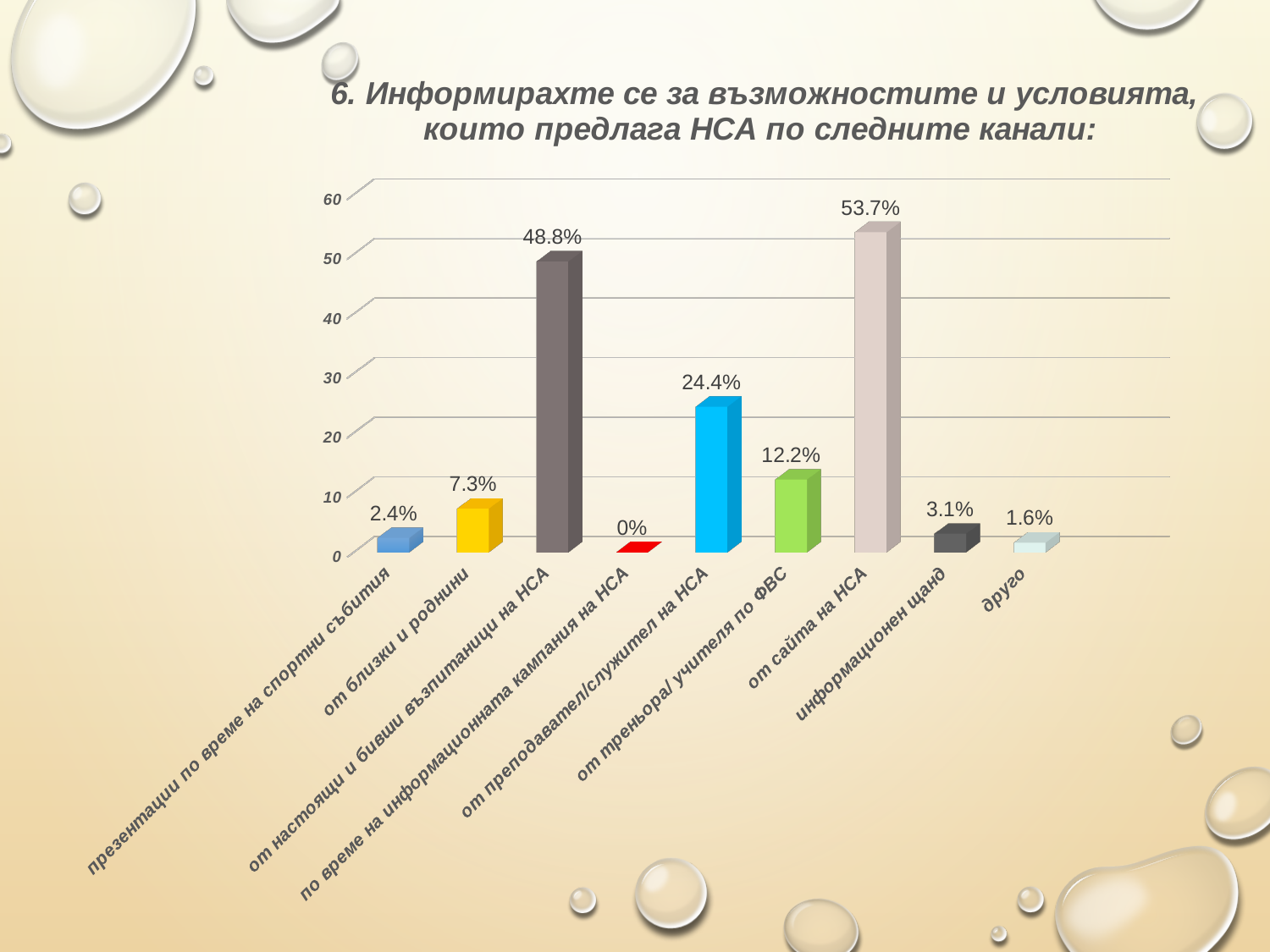
What kind of chart is shown on the slide? bar chart What is the difference between the values for "от сайта на НСА" and "от настоящи и бивши възпитаници на НСА"? 4.9% What is the value for "от преподавател/служител на НСА"? 24.4% What is the value for "информационен щанд"? 3.1% Is the value for "от преподавател/служител на НСА" greater or less than 20? greater What is the value for "от настоящи и бивши възпитаници на НСА"? 48.8% Which category has the highest value? от сайта на НСА Which is larger: the value for "от треньора/учителя по ФВС" or the value for "от близки и роднини"? от треньора/учителя по ФВС What is the value for "от сайта на НСА"? 53.7% How many categories (channels) are plotted in the chart? 9 Which category has the lowest value? по време на информационната кампания на НСА What is the value for "по време на информационната кампания на НСА"? 0%